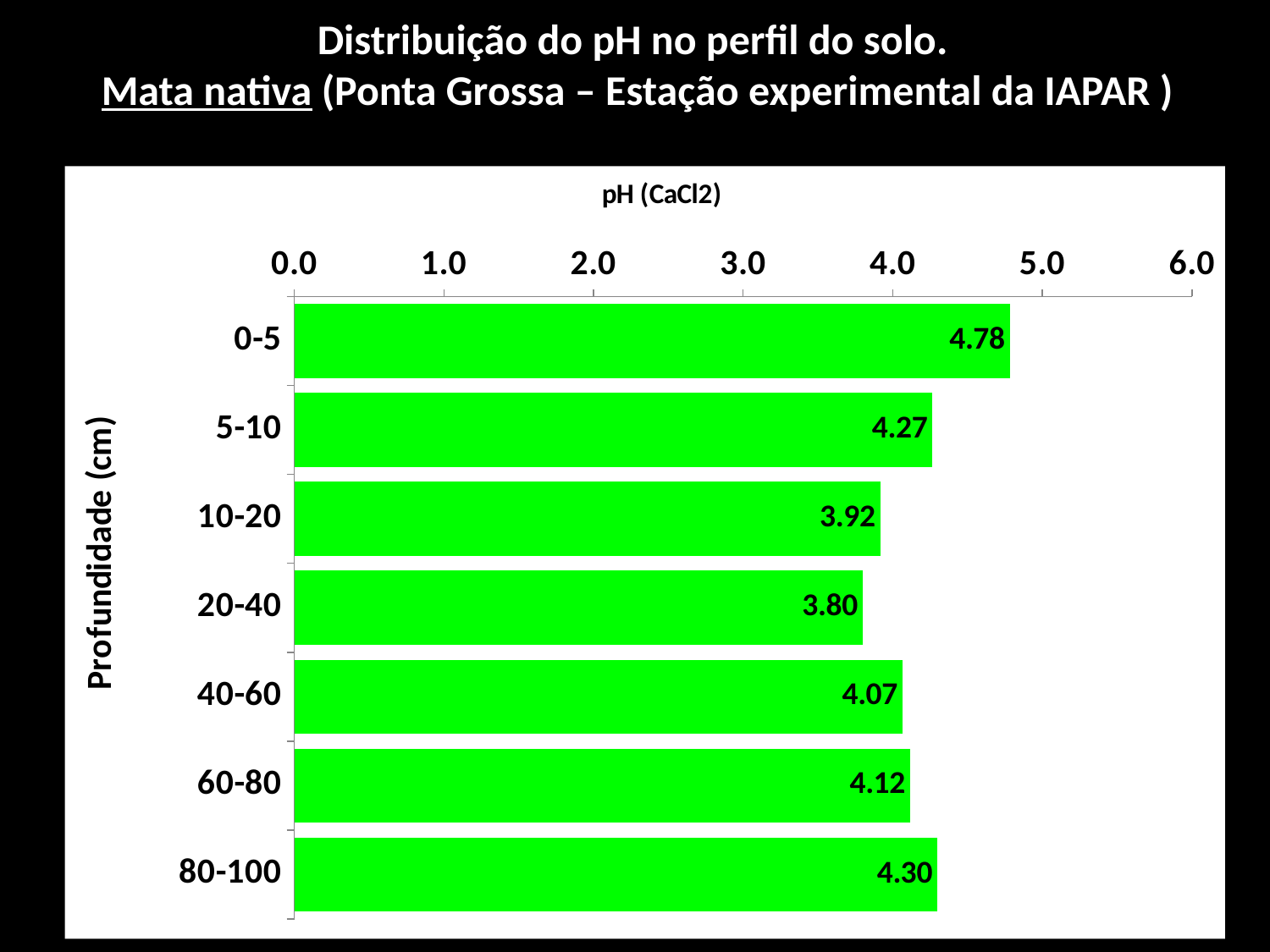
What is the label of the horizontal axis? pH (CaCl2) What is the pH (CaCl2) value for the 0-5 cm depth? 4.78 What is the difference between the pH at 0-5 cm and the pH at 5-10 cm? 0.51 How many depth categories are shown in the chart? 7 Which depth has the lowest pH value? 20-40 Which has a higher pH value, the 40-60 cm depth or the 60-80 cm depth? 60-80 What is the pH (CaCl2) value for the 80-100 cm depth? 4.30 What is the label of the vertical axis? Profundidade (cm) What is the pH (CaCl2) value for the 20-40 cm depth? 3.80 Which depth has the highest pH value? 0-5 What kind of chart is shown on the slide? bar chart Is the pH value for the 10-20 cm depth greater or less than 4.0? less